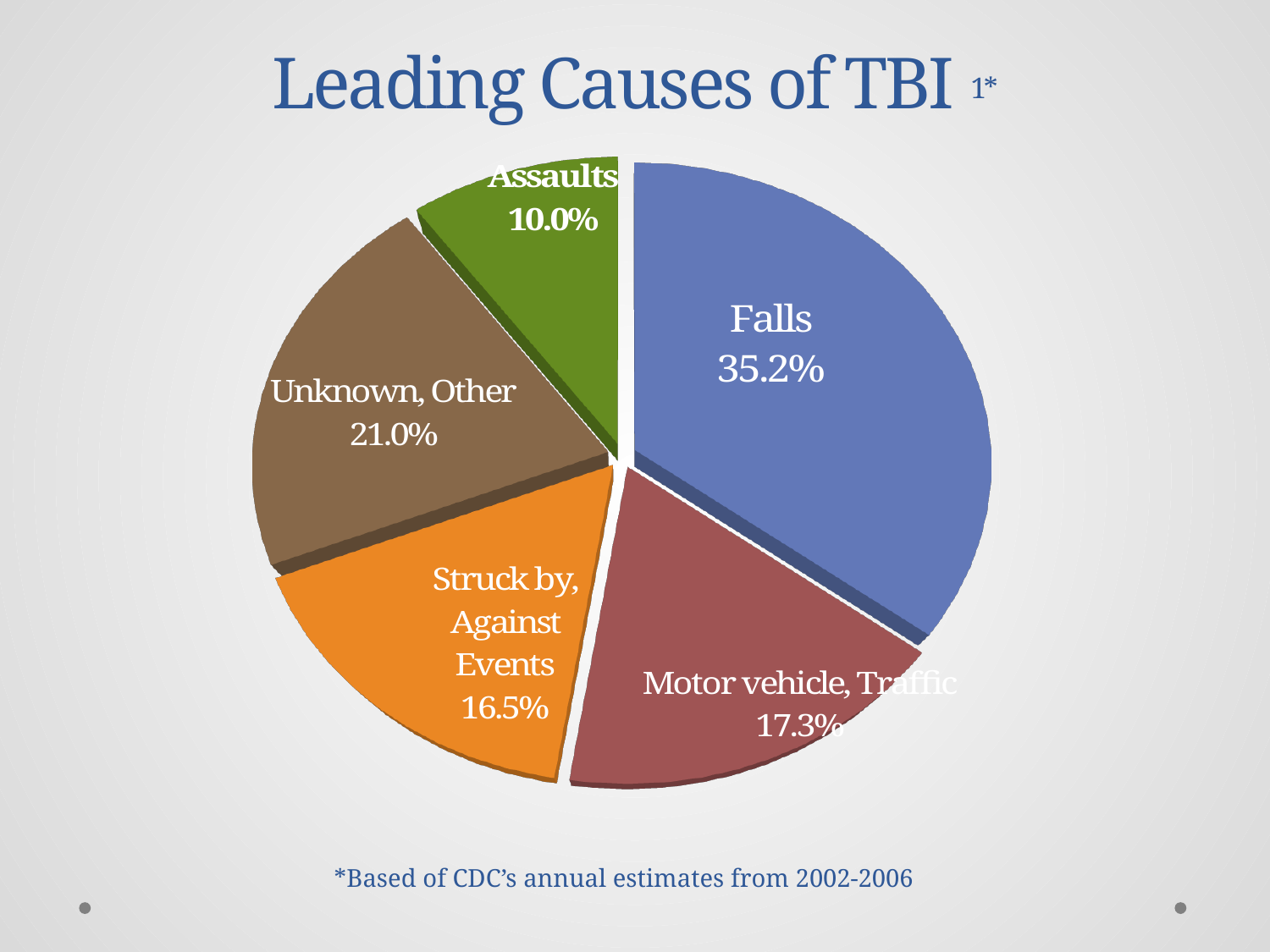
What percentage is shown for Motor vehicle, Traffic? 17.3% Which cause has the largest share of the pie? Falls Which is larger, the share for Unknown, Other or the share for Motor vehicle, Traffic? Unknown, Other What percentage is shown for Unknown, Other? 21.0% What percentage of TBI cases is attributed to Falls? 35.2% What is the difference in percentage points between Falls and Unknown, Other? 14.2 What percentage is shown for Assaults? 10.0% What is the title of the chart? Leading Causes of TBI Which cause has the smallest share of the pie? Assaults What percentage is shown for Struck by, Against Events? 16.5% How many slices does the pie chart have? 5 What type of chart is shown on the slide? pie chart